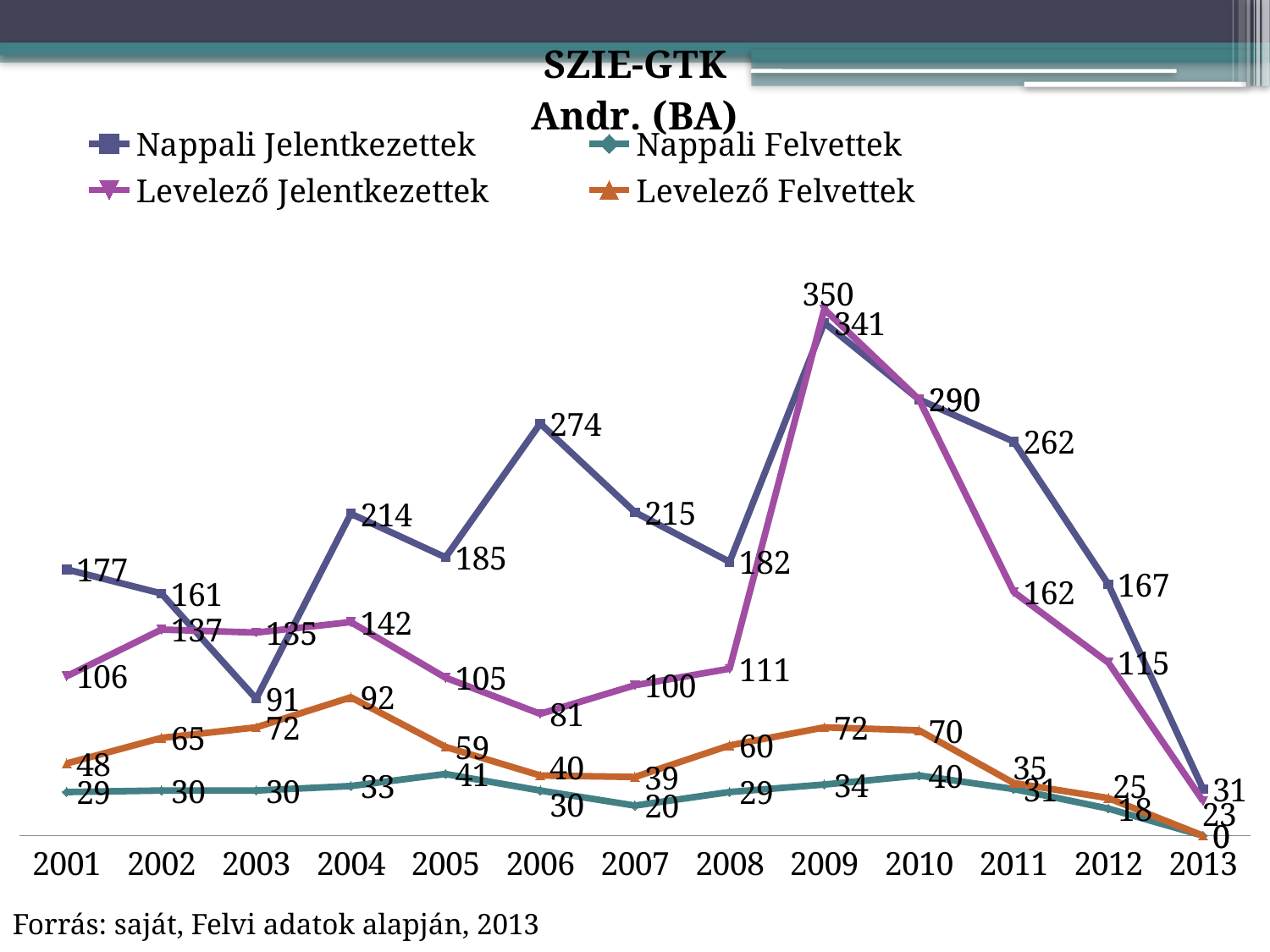
In 2004, which is larger: Nappali Jelentkezettek or Levelező Jelentkezettek? Nappali Jelentkezettek What is the value for Levelező Felvettek in 2004? 92 What kind of chart is shown on the slide? line chart How many series does the legend list? 4 What is the value for Levelező Jelentkezettek in 2009? 350 In which year is Nappali Jelentkezettek lowest? 2013 What is the value for Nappali Jelentkezettek in 2006? 274 What is the title of the chart? SZIE-GTK Andr. (BA) Does Nappali Jelentkezettek rise or fall from 2009 to 2013? fall How many years are plotted along the x axis? 13 In which year is Levelező Jelentkezettek highest? 2009 What is the difference between Nappali Jelentkezettek in 2009 and in 2008? 159